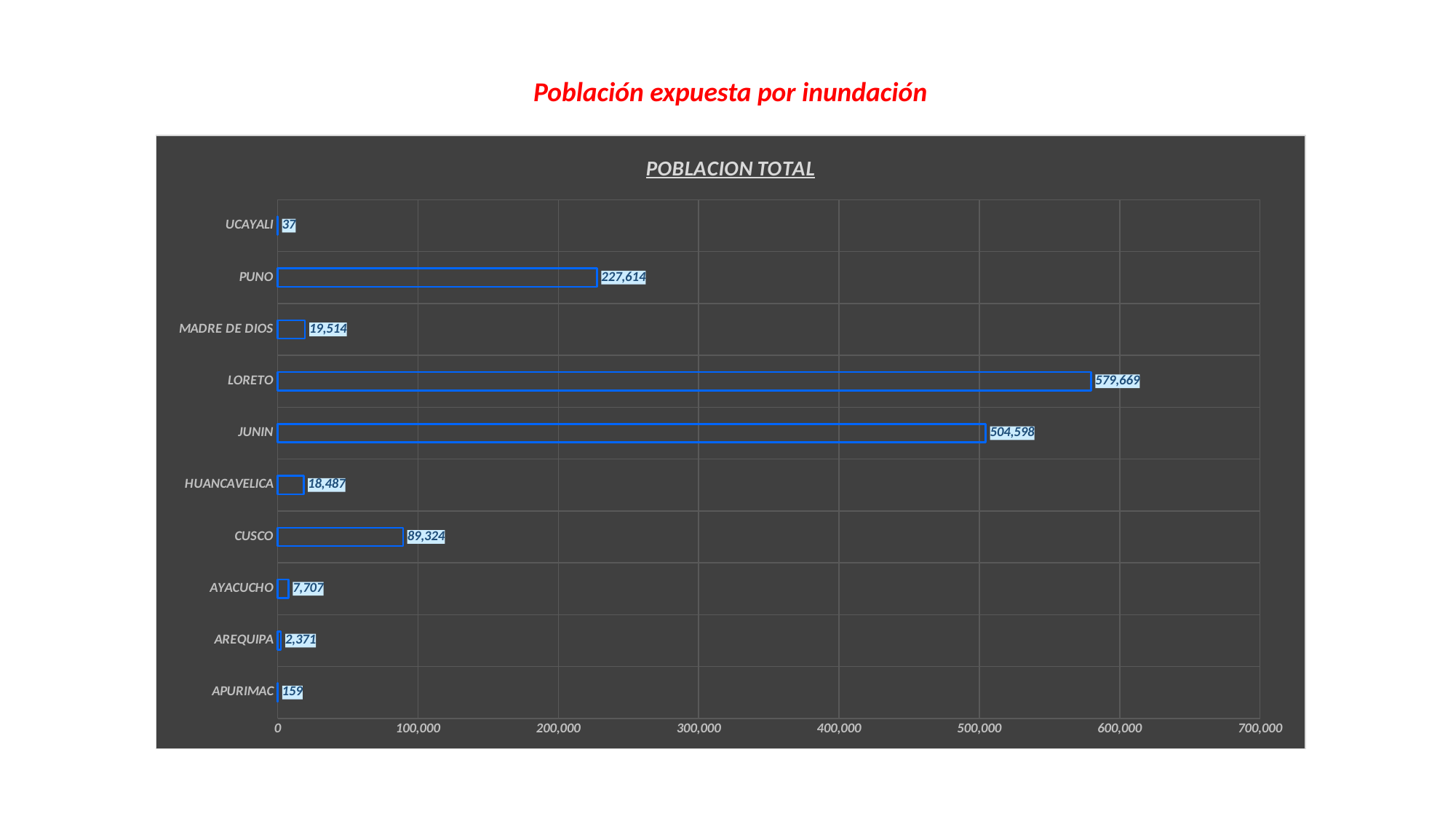
What is the value for PUNO? 227,614 What is the difference between the values for LORETO and JUNIN? 75,071 Is the value for JUNIN greater or less than 500,000? greater What is the value for LORETO? 579,669 Which is larger, the value for CUSCO or the value for PUNO? PUNO How many categories are shown on the chart? 10 What is the value for HUANCAVELICA? 18,487 Which category has the lowest value? UCAYALI What is the title of the chart? POBLACION TOTAL Which category has the highest value? LORETO What kind of chart is shown? bar chart What is the value for AYACUCHO? 7,707